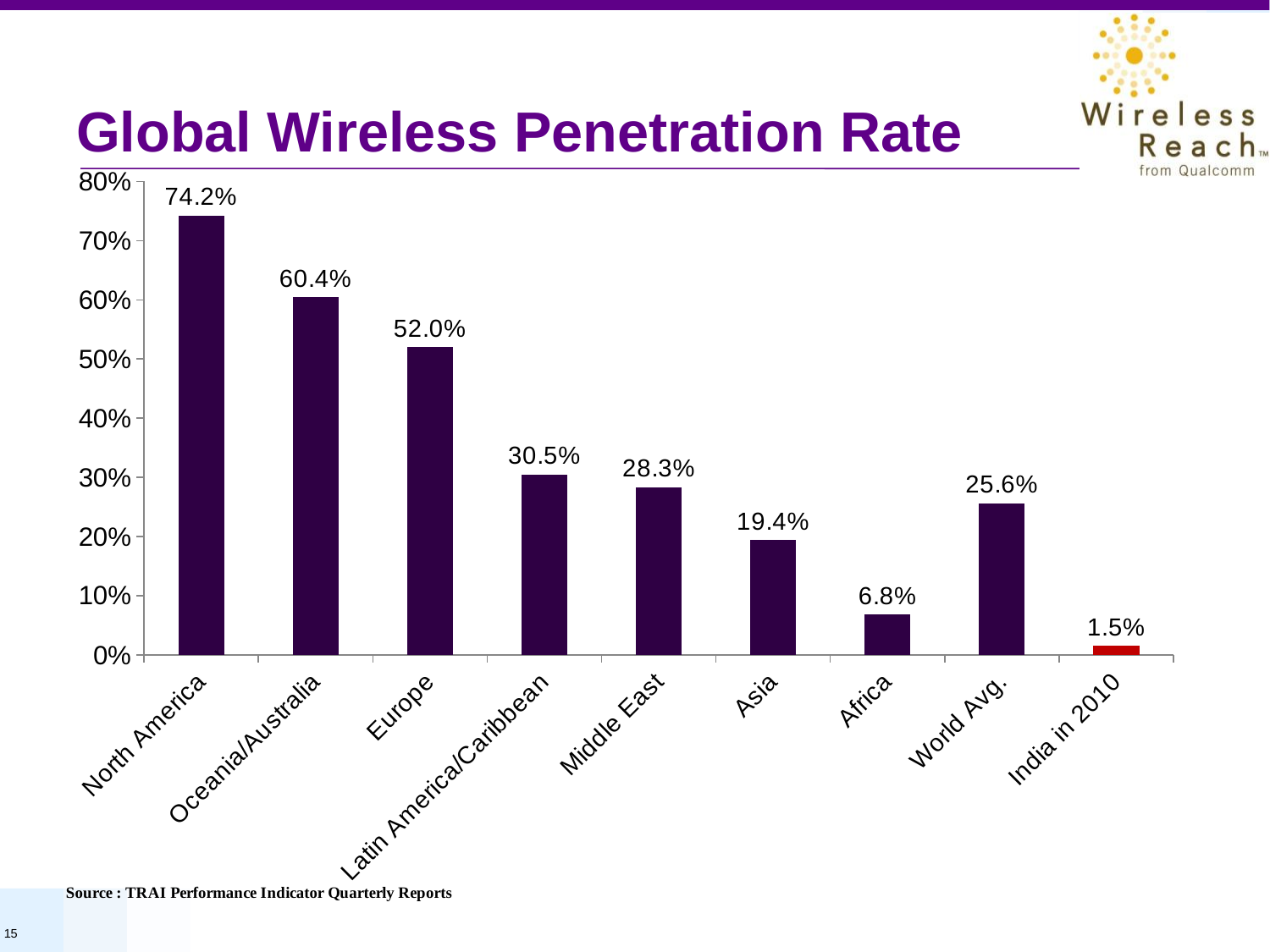
What is the wireless penetration rate for North America? 74.2% How many categories are shown on the x axis? 9 What is the value shown for India in 2010? 1.5% Which category has the highest wireless penetration rate? North America What kind of chart is shown on the slide? Bar chart Which has a higher penetration rate, Middle East or Asia? Middle East Which bar is shown in a different colour (red) from the others? India in 2010 What is the wireless penetration rate for Europe? 52.0% What is the difference between the penetration rates of Oceania/Australia and Europe? 8.4% What is the World Avg. wireless penetration rate? 25.6% Is the value for Africa greater or less than 10%? less Which category has the lowest wireless penetration rate? India in 2010